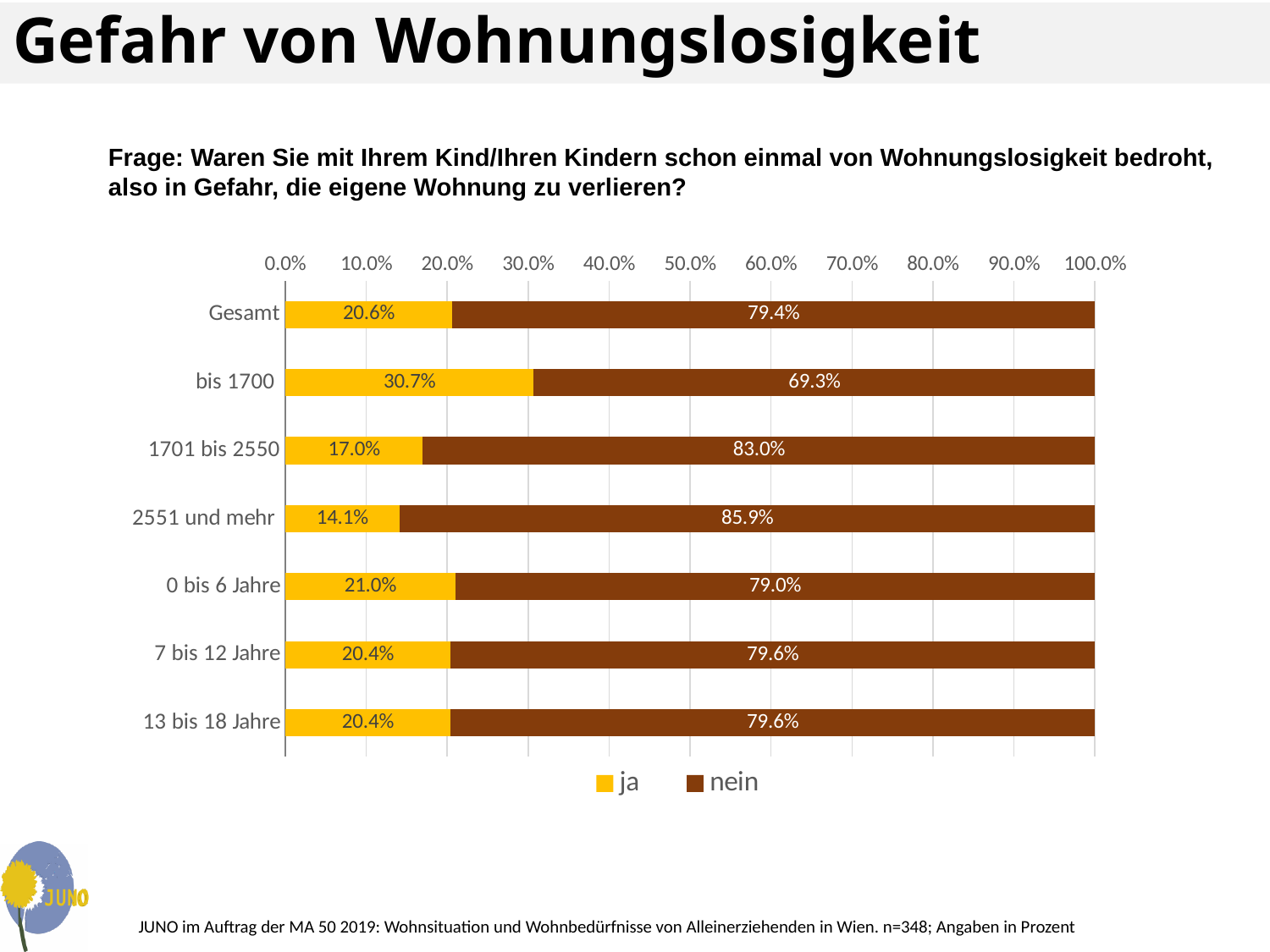
Which category has the lowest "ja" value? 2551 und mehr How many series does the legend list? 2 What kind of chart is shown on the slide? Stacked bar chart What is the difference between the "ja" values for bis 1700 and 2551 und mehr? 16.6% What is the "ja" value for 2551 und mehr? 14.1% What is the "ja" value for Gesamt? 20.6% Which is larger, the "ja" value for 0 bis 6 Jahre or for 1701 bis 2550? 0 bis 6 Jahre What is the "nein" value for bis 1700? 69.3% How many categories are shown on the chart? 7 What is the "nein" value for 1701 bis 2550? 83.0% Which category has the highest "ja" value? bis 1700 Is the "nein" value for bis 1700 greater or less than 70.0%? less